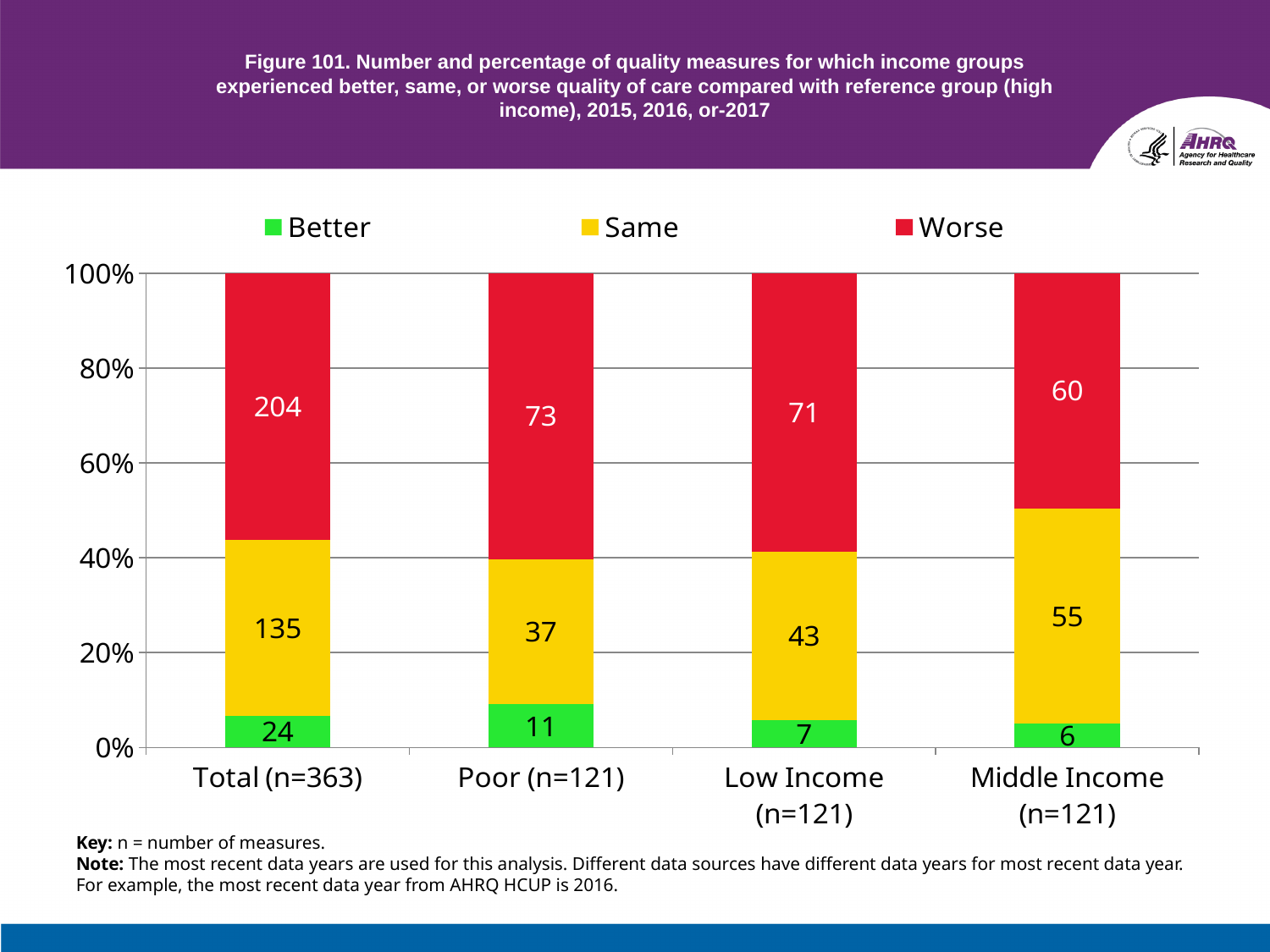
Which category has the highest 'Better' value? Total (n=363) What kind of chart is shown on the slide? Stacked bar chart Among Poor, Low Income and Middle Income, which category has the lowest 'Worse' value? Middle Income (n=121) Is the 'Better' share of the Poor (n=121) bar greater or less than 20%? less What is the total number of measures in the Low Income (n=121) bar (Better + Same + Worse)? 121 What is the number of measures labelled 'Same' for Low Income (n=121)? 43 How many series does the legend list? 3 Which is larger: the 'Worse' value for Poor (n=121) or the 'Worse' value for Low Income (n=121)? Poor (n=121) How many income group categories are shown on the x axis? 4 What is the difference between the 'Same' values for Middle Income (n=121) and Poor (n=121)? 18 What is the number of measures labelled 'Better' for Middle Income (n=121)? 6 What is the number of measures labelled 'Worse' for Total (n=363)? 204